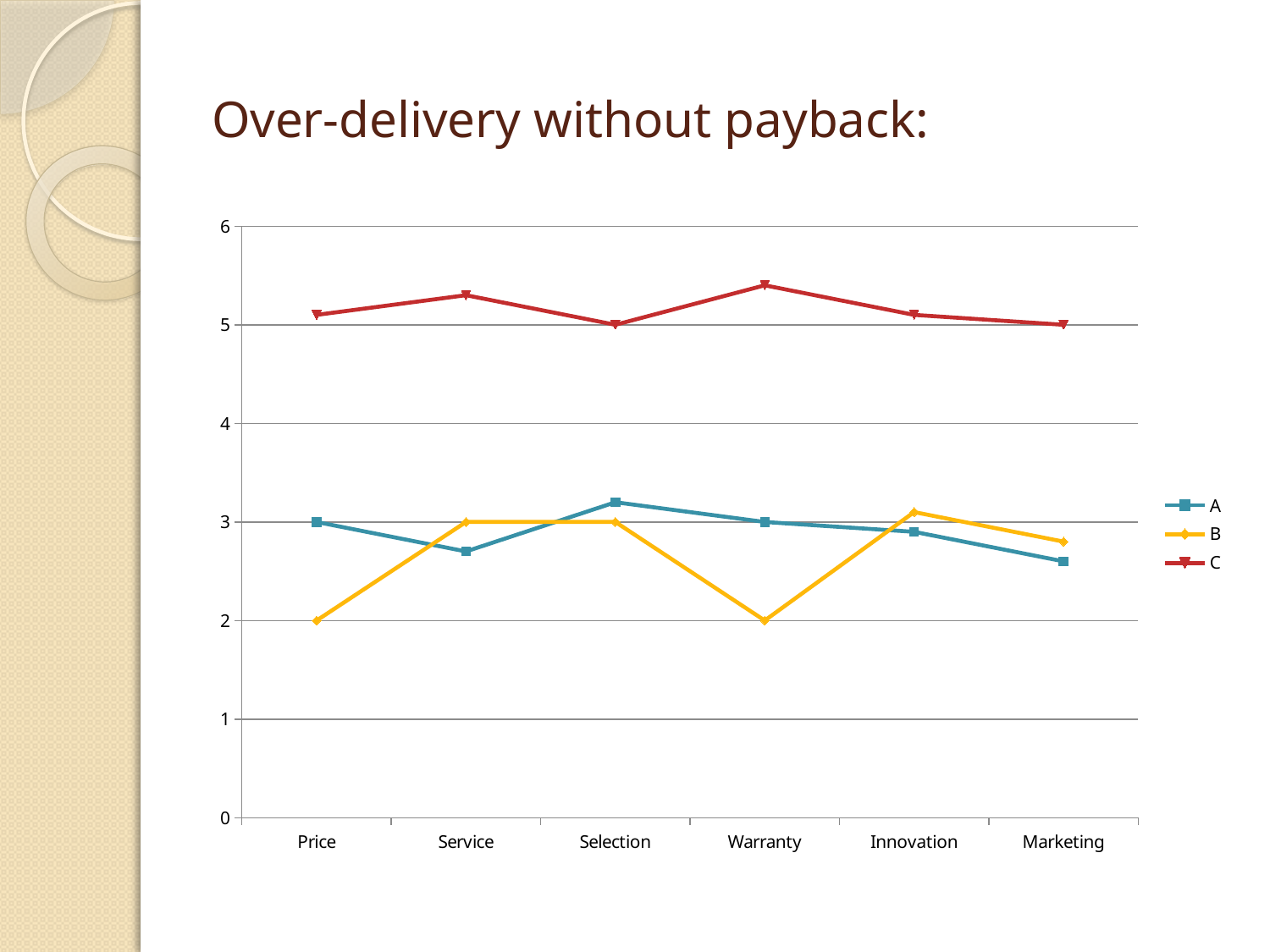
How many categories are shown on the x axis? 6 What is the value of series B for Price? 2 Is the value of series A for Marketing greater or less than 3? less What is the title of the slide? Over-delivery without payback: How many series does the legend list? 3 For Warranty, which series has the larger value, A or B? A What kind of chart is shown on the slide? line chart What is the value of series A for Price? 3 Which series has the highest values across all categories? C What is the value of series B for Warranty? 2 Is the value of series C for Warranty greater or less than 5? greater What is the value of series C for Selection? 5